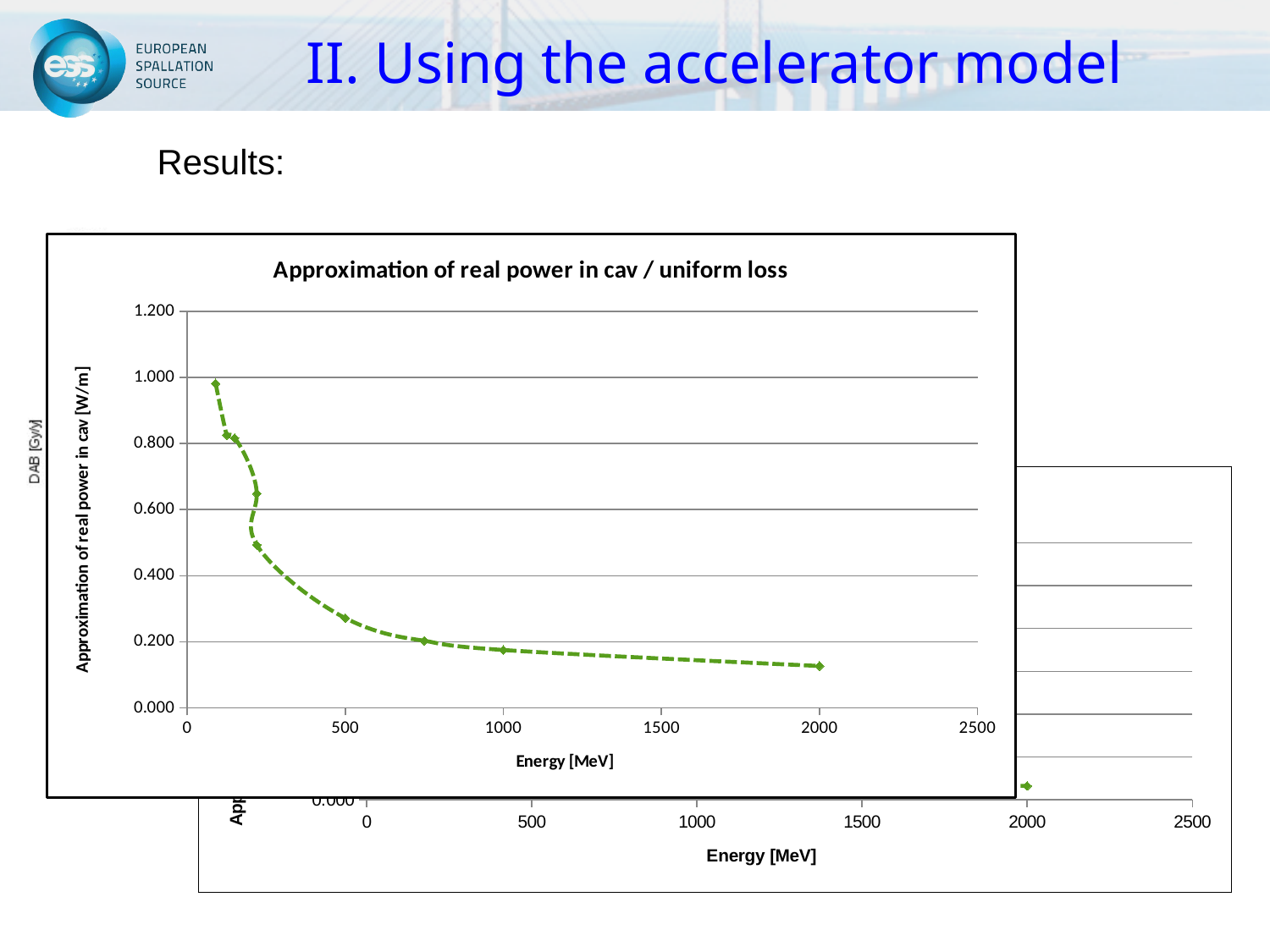
In the chart "Approximation of real power in cav / uniform loss", is the value at 500 MeV greater or less than 0.400? less In the chart "Approximation of real power in cav / uniform loss", which is larger: the value at 500 MeV or the value at 2000 MeV? 500 MeV In the chart "Approximation of real power in cav / uniform loss", which is larger: the value at 750 MeV or the value at 1000 MeV? 750 MeV In the chart "Approximation of real power in cav / uniform loss", is the highest plotted value greater or less than 0.800? greater In the chart "Approximation of real power in cav / uniform loss", is the value at 500 MeV greater or less than 0.200? greater What kind of chart is shown under the title "Approximation of real power in cav / uniform loss"? line chart In the chart "Approximation of real power in cav / uniform loss", do the values rise or fall as Energy [MeV] increases? fall What is the highest tick value shown on the y-axis of the chart "Approximation of real power in cav / uniform loss"? 1.200 What is the x-axis label of the chart "Approximation of real power in cav / uniform loss"? Energy [MeV]